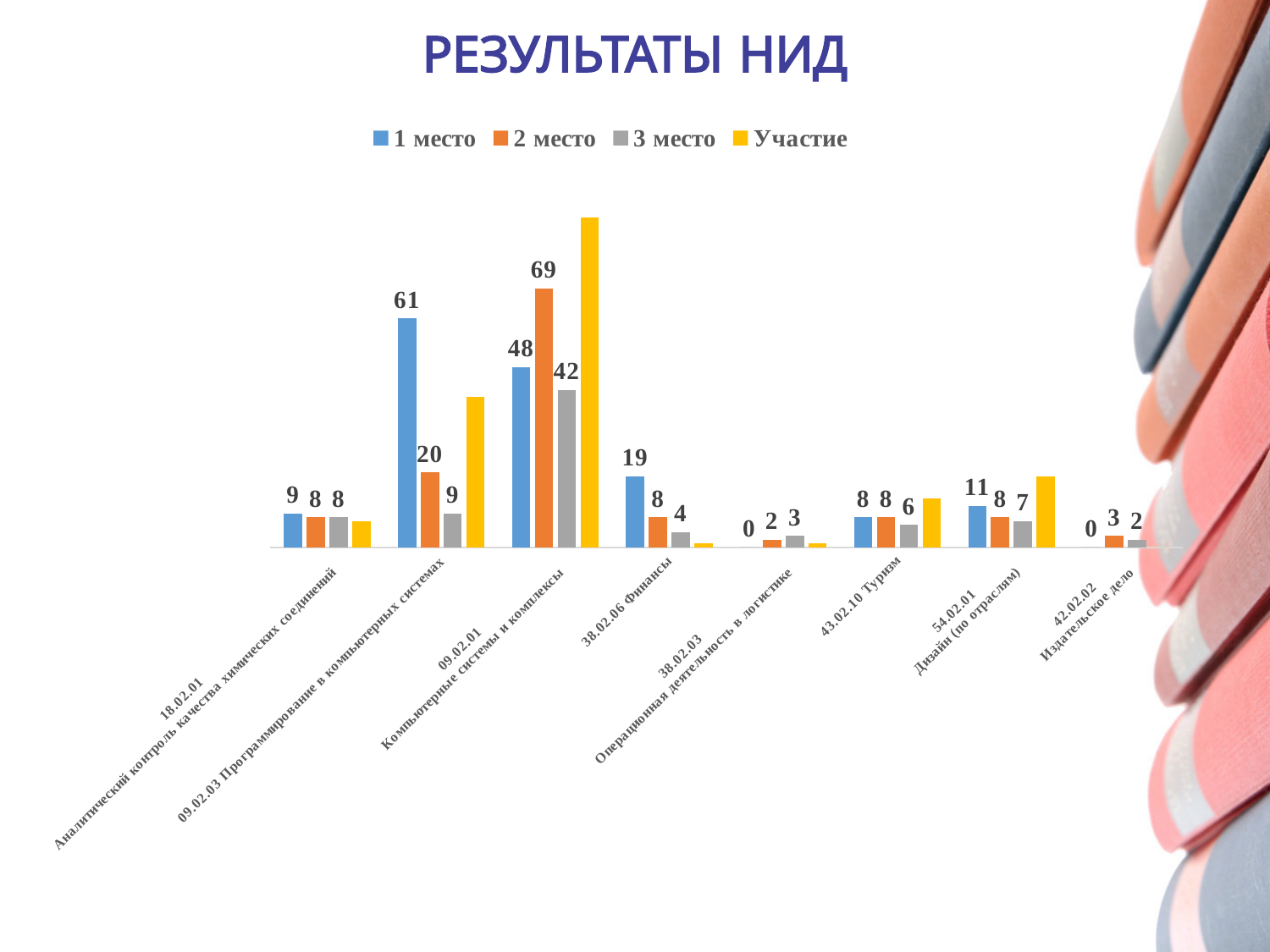
What is the value of "3 место" for 38.02.06 Финансы? 4 What is the title of the chart? РЕЗУЛЬТАТЫ НИД What is the value of "1 место" for 42.02.02 Издательское дело? 0 Which category has the highest value for "3 место"? 09.02.01 Компьютерные системы и комплексы How many categories (specialties) are shown on the x axis? 8 What type of chart is shown on the slide? bar chart What is the difference between "1 место" and "2 место" for 09.02.03 Программирование в компьютерных системах? 41 Which category has the highest value for "1 место"? 09.02.03 Программирование в компьютерных системах Which is larger for 09.02.01 Компьютерные системы и комплексы: "1 место" or "2 место"? 2 место How many series does the legend list? 4 What is the value of "2 место" for 09.02.01 Компьютерные системы и комплексы? 69 What is the value of "1 место" for 09.02.03 Программирование в компьютерных системах? 61